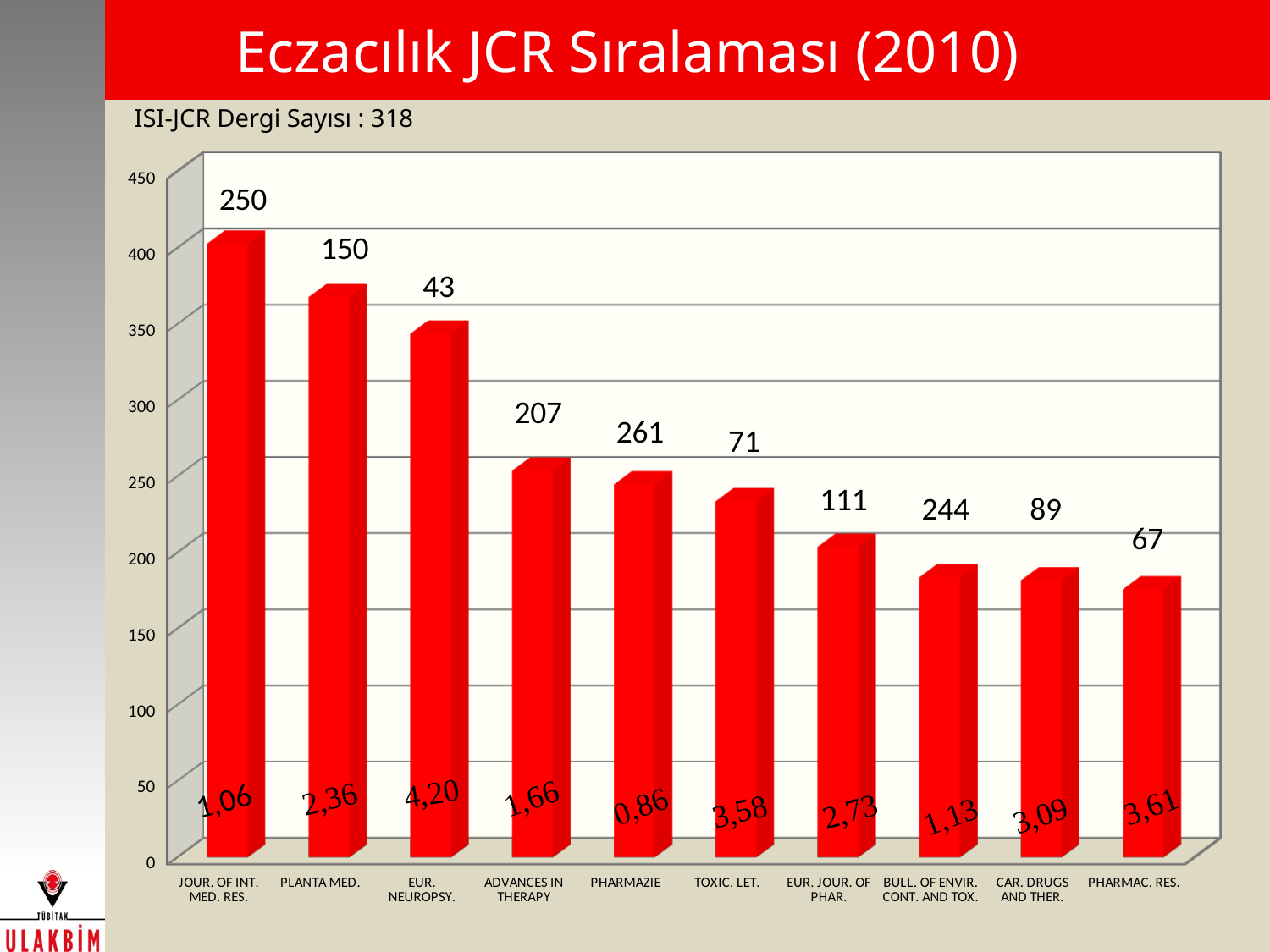
Is the bar for JOUR. OF INT. MED. RES. greater or less than 350? greater Which journal has the tallest bar in the chart? JOUR. OF INT. MED. RES. What is the title of the slide containing the chart? Eczacılık JCR Sıralaması (2010) Is the bar for ADVANCES IN THERAPY greater or less than 200? greater What kind of chart is shown on the slide? bar chart What number is given for ISI-JCR Dergi Sayısı above the chart? 318 How many categories (journals) are shown on the x axis of the chart? 10 What value is printed on the bar for EUR. NEUROPSY.? 4,20 Which bar is taller, PLANTA MED. or PHARMAZIE? PLANTA MED. Is the bar for PHARMAC. RES. greater or less than 200? less What number is printed above the bar for PLANTA MED.? 150 Do the bar heights generally rise or fall from left to right across the chart? fall